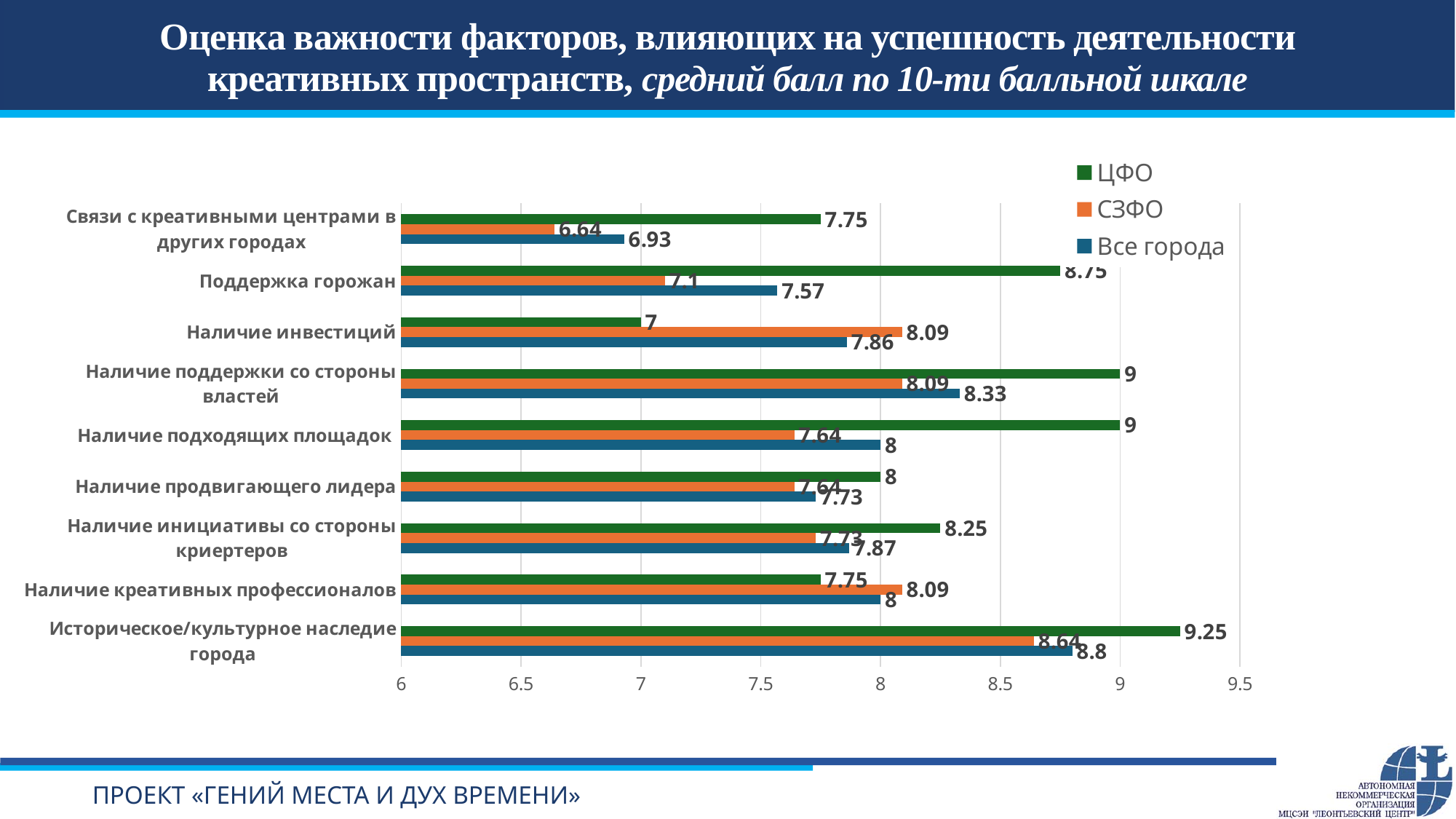
What is the ЦФО value for «Историческое/культурное наследие города»? 9.25 How many series does the legend list? 3 How many factors (categories) are plotted on the chart? 9 Which series is shown in orange in the legend? СЗФО What is the «Все города» value for «Наличие поддержки со стороны властей»? 8.33 Which factor has the highest ЦФО value? Историческое/культурное наследие города For «Наличие инвестиций», which is larger: the ЦФО value or the СЗФО value? СЗФО What type of chart is shown on the slide? bar chart What is the СЗФО value for «Связи с креативными центрами в других городах»? 6.64 Which factor has the lowest «Все города» value? Связи с креативными центрами в других городах What is the difference between the ЦФО and СЗФО values for «Поддержка горожан»? 1.65 Which factor has the lowest ЦФО value? Наличие инвестиций